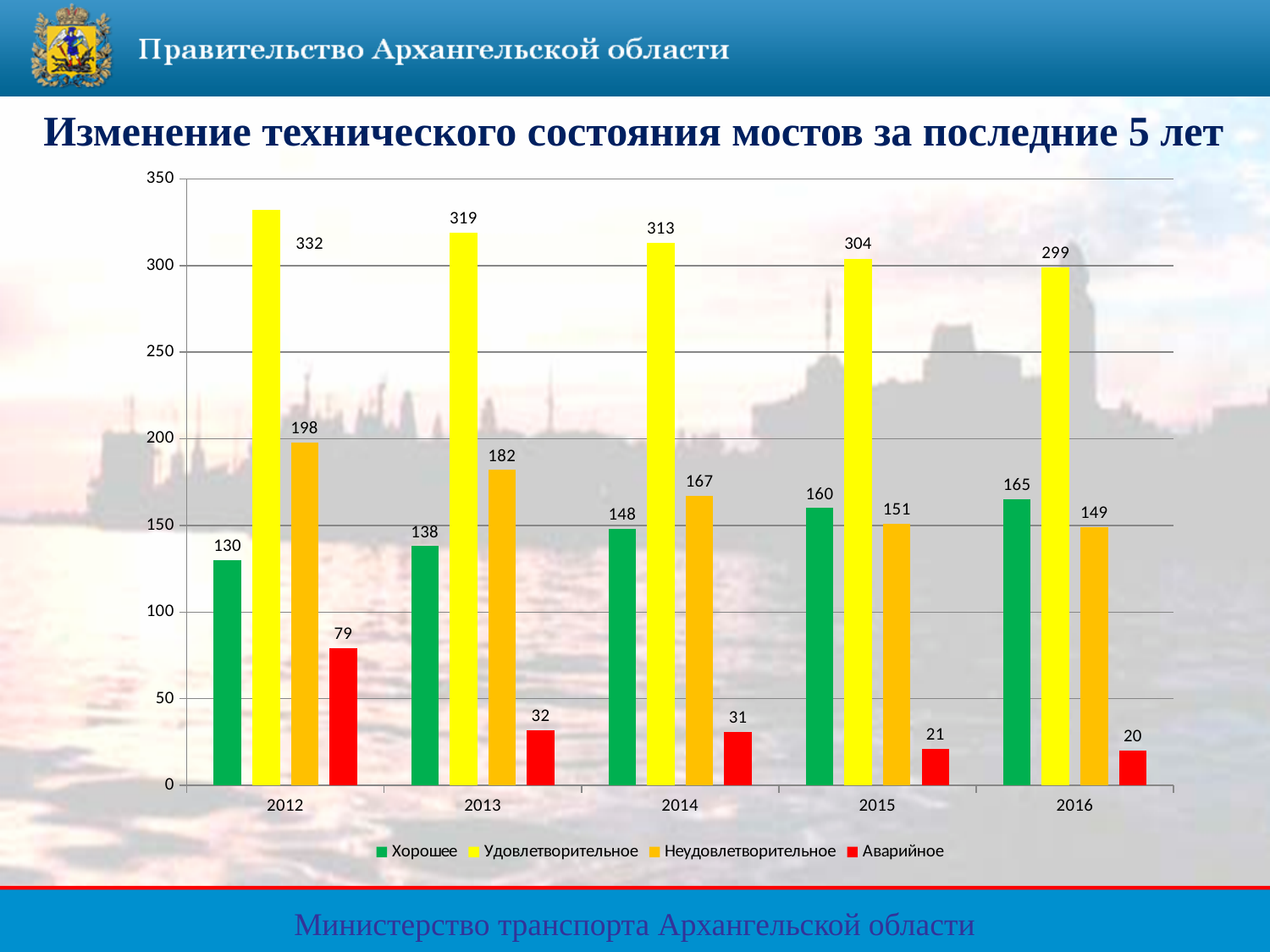
How many series does the legend list? 4 What is the value for Аварийное in 2013? 32 What kind of chart is shown on the slide? Bar chart What is the value for Удовлетворительное in 2016? 299 Does the value for Хорошее rise or fall from 2012 to 2016? Rise What is the difference between the Удовлетворительное values in 2012 and 2016? 33 What is the value for Хорошее in 2012? 130 How many years are shown on the x axis? 5 In which year is the value for Хорошее lowest? 2012 What is the value for Неудовлетворительное in 2014? 167 Which is larger: Хорошее in 2015 or Неудовлетворительное in 2015? Хорошее in 2015 In which year is the value for Аварийное highest? 2012